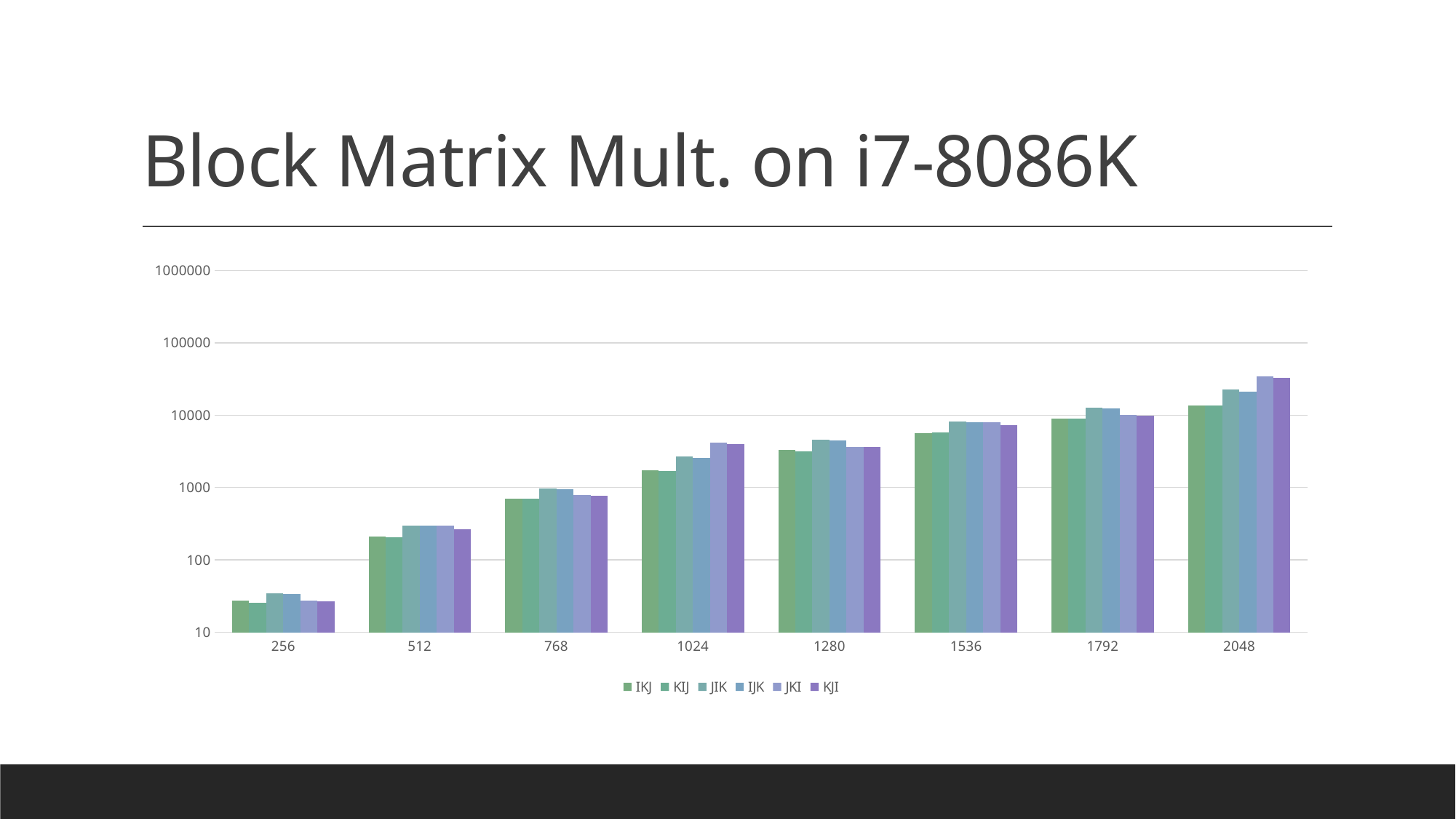
What is the title of the chart on the slide? Block Matrix Mult. on i7-8086K How many categories are shown along the x axis? 8 Which category on the x axis has the highest bars? 2048 At 2048, which is larger, the value for JKI or the value for IKJ? JKI How many series does the legend list? 6 Which category on the x axis has the lowest bars? 256 What kind of chart is shown on the slide? bar chart Is the value for JKI at 2048 greater or less than 10000? greater Do the values generally rise or fall as the matrix size increases along the x axis? rise What is the highest value labelled on the y axis? 1000000 Is the value for IKJ at 768 greater or less than 1000? less Is the value for IKJ at 256 greater or less than 100? less